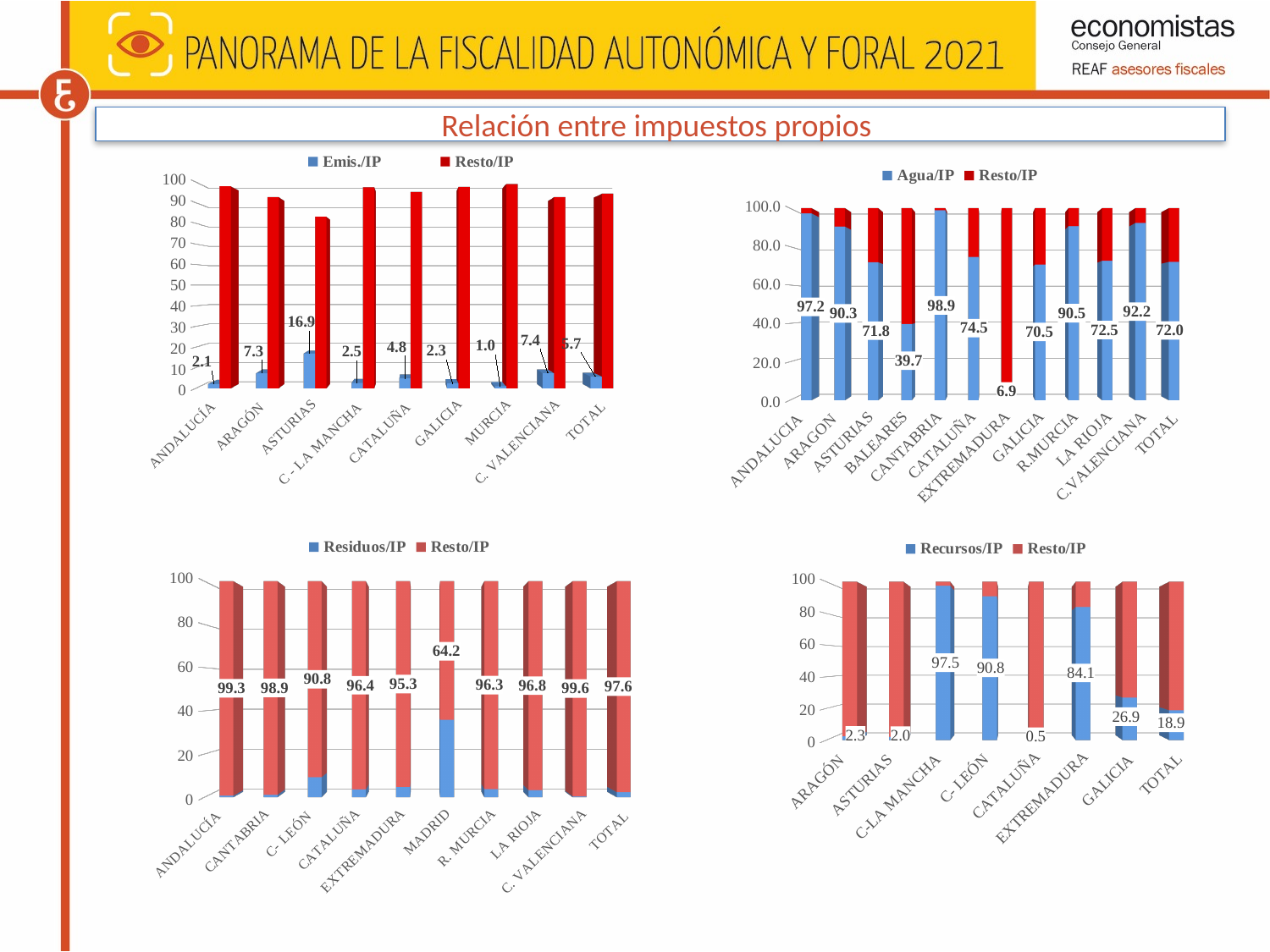
In the top-left chart (Emis./IP), how many categories are shown on the x axis? 9 In the top-left chart (Emis./IP), which category has the lowest Emis./IP value? MURCIA In the top-right chart (Agua/IP), what is the difference between the Agua/IP values for ANDALUCIA and EXTREMADURA? 90.3 In the top-right chart (Agua/IP), how many series does the legend list? 2 In the top-right chart (Agua/IP), what is the Agua/IP value for BALEARES? 39.7 In the bottom-right chart (Recursos/IP), which is larger, the Recursos/IP value for GALICIA or for TOTAL? GALICIA In the top-left chart (Emis./IP), what is the Emis./IP value for ASTURIAS? 16.9 What kind of chart is the bottom-right chart (Recursos/IP)? Stacked bar chart In the bottom-left chart (Residuos/IP), which category has the highest Resto/IP value? C. VALENCIANA In the bottom-left chart (Residuos/IP), what is the Resto/IP value for MADRID? 64.2 In the top-right chart (Agua/IP), which category has the highest Agua/IP value? CANTABRIA In the bottom-right chart (Recursos/IP), what is the Recursos/IP value for EXTREMADURA? 84.1